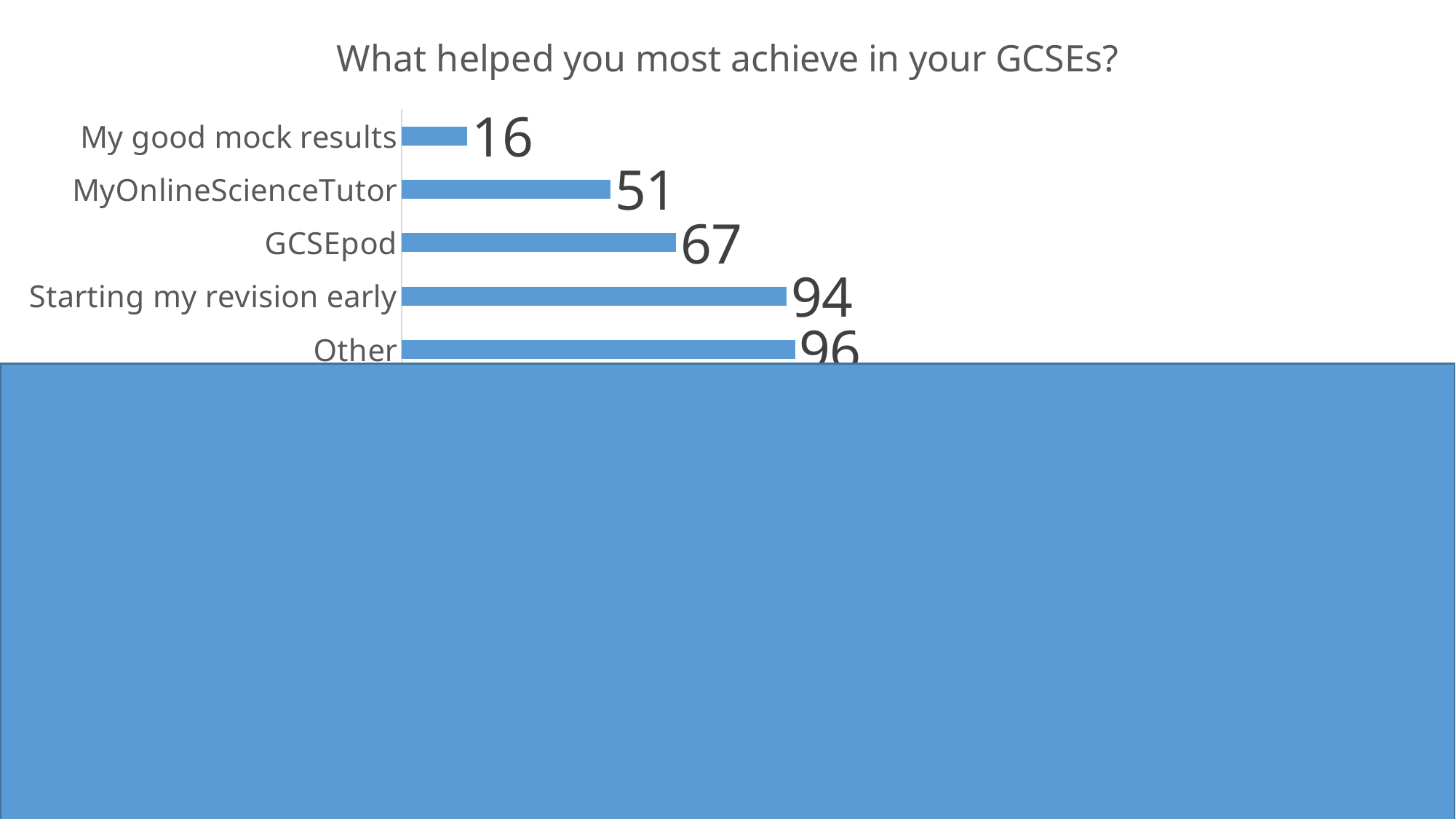
What kind of chart is shown on the slide? Bar chart What is the difference between the values for Starting my revision early and My good mock results? 78 What is the value for Starting my revision early? 94 What is the value for MyOnlineScienceTutor? 51 Which category has the lowest value? My good mock results Which is larger, the value for GCSEpod or the value for MyOnlineScienceTutor? GCSEpod What is the value for GCSEpod? 67 What is the title of the chart? What helped you most achieve in your GCSEs? What is the difference between the values for GCSEpod and MyOnlineScienceTutor? 16 What is the value for My good mock results? 16